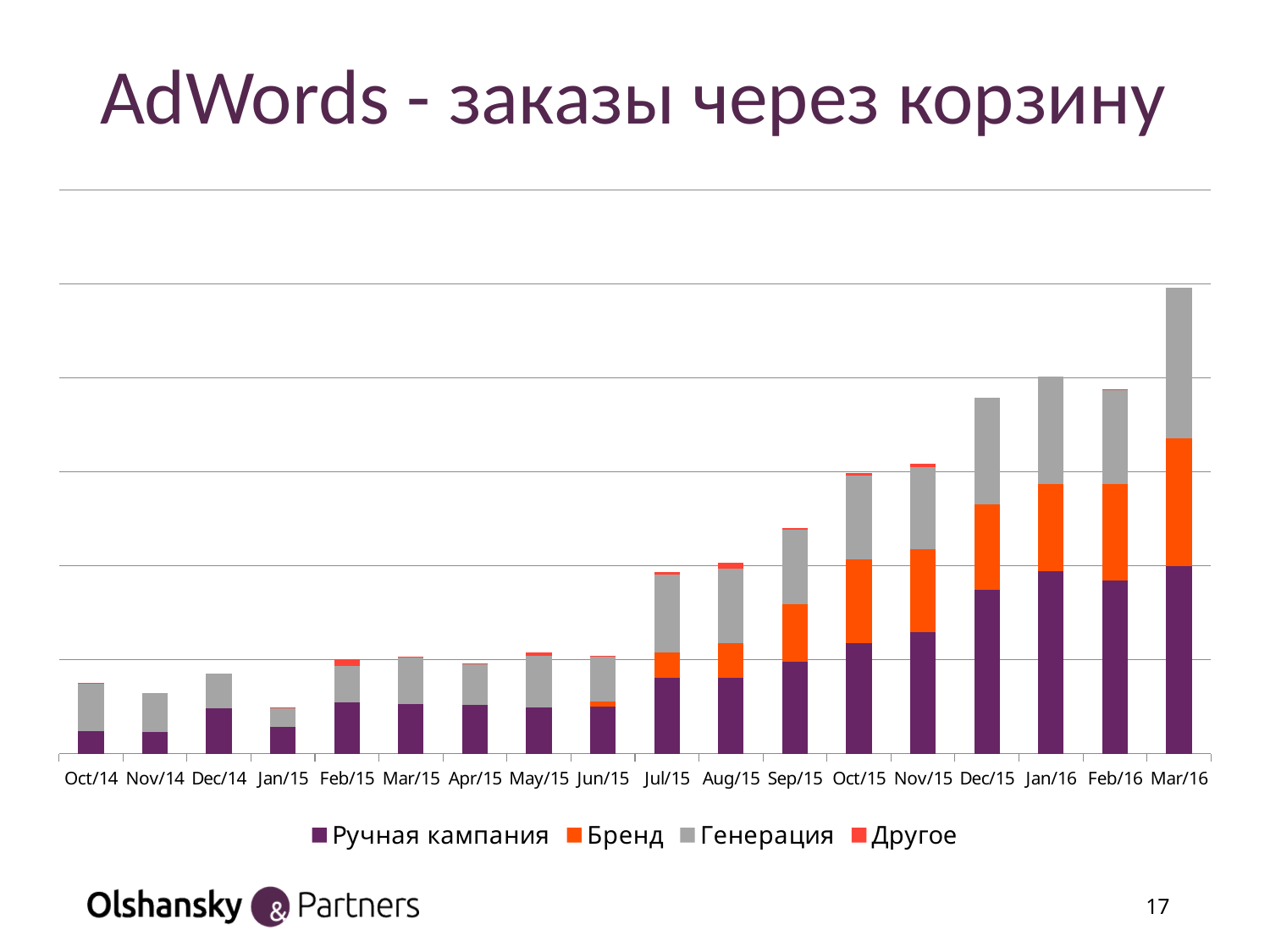
Which total bar is taller, Jul/15 or Sep/15? Sep/15 Which month has the lowest total bar? Jan/15 Which series has the largest segment in the Mar/16 bar? Ручная кампания What is the title of the chart slide? AdWords - заказы через корзину How many months (categories) are shown on the x axis? 18 Which series is shown in grey in the legend? Генерация Which month has the highest total bar? Mar/16 What kind of chart is shown on the slide? Stacked bar chart Which is larger, the Ручная кампания segment in Mar/16 or in Oct/14? Mar/16 Do the total bar heights generally rise or fall from Oct/14 to Mar/16? Rise How many series does the legend list? 4